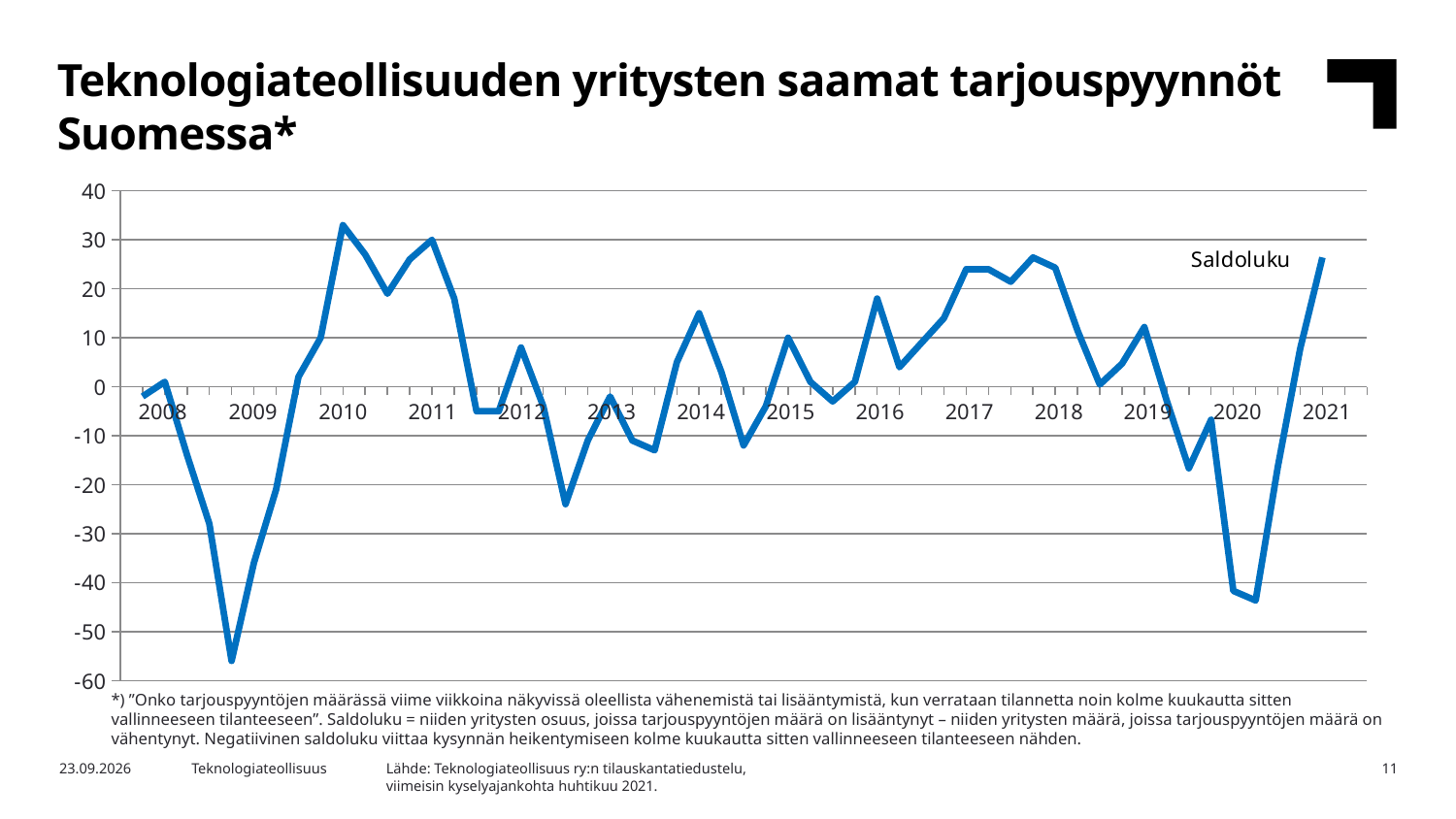
What kind of chart is shown on the slide? line chart Is the peak value of the Saldoluku line in 2010 greater or less than 30? greater What is the name of the series plotted in the chart? Saldoluku Is the Saldoluku value at the start of 2009 greater or less than -20? less In which year does the Saldoluku line reach its lowest point? 2009 Is the final value of the Saldoluku line in 2021 greater or less than 20? greater Does the Saldoluku line rise or fall between its 2020 low point and the end of the series in 2021? rise What is the title of the chart on the slide? Teknologiateollisuuden yritysten saamat tarjouspyynnöt Suomessa* Which is larger: the Saldoluku peak in 2010 or the Saldoluku low point in 2009? the 2010 peak How many series does the chart plot? 1